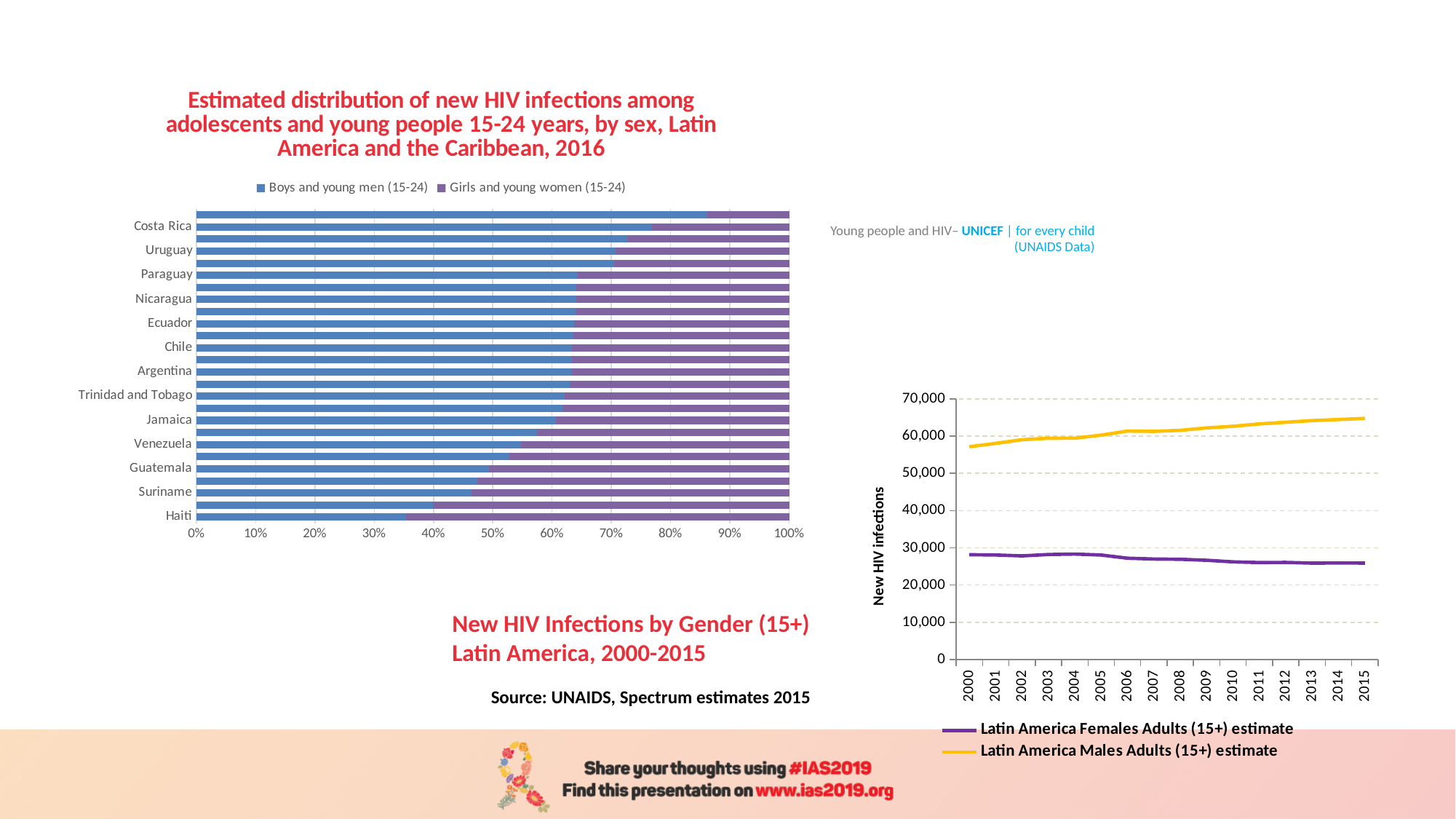
In the left chart (distribution of new HIV infections by sex), which is larger for Haiti: the share for Boys and young men (15-24) or the share for Girls and young women (15-24)? Girls and young women (15-24) In the left chart (distribution of new HIV infections by sex), which labelled country has the smallest share for Boys and young men (15-24)? Haiti In the left chart (distribution of new HIV infections by sex), which labelled country has the largest share for Boys and young men (15-24)? Costa Rica In the right chart (New HIV Infections by Gender (15+)), how many years are shown on the x axis? 16 In the left chart (distribution of new HIV infections by sex), is the share for Boys and young men (15-24) in Haiti greater or less than 40%? less What kind of chart is the right chart, 'New HIV Infections by Gender (15+) Latin America, 2000-2015'? line chart In the right chart (New HIV Infections by Gender (15+)), does the Latin America Females Adults (15+) estimate rise or fall from 2000 to 2015? fall In the right chart (New HIV Infections by Gender (15+)), is the value for Latin America Males Adults (15+) estimate in 2015 greater or less than 60,000? greater How many series does the legend of the left chart (distribution of new HIV infections by sex) list? 2 What kind of chart is the left chart, 'Estimated distribution of new HIV infections among adolescents and young people 15-24 years, by sex'? bar chart In the left chart (distribution of new HIV infections by sex), is the share for Boys and young men (15-24) in Costa Rica greater or less than 80%? less How many series does the legend of the right chart (New HIV Infections by Gender (15+)) list? 2